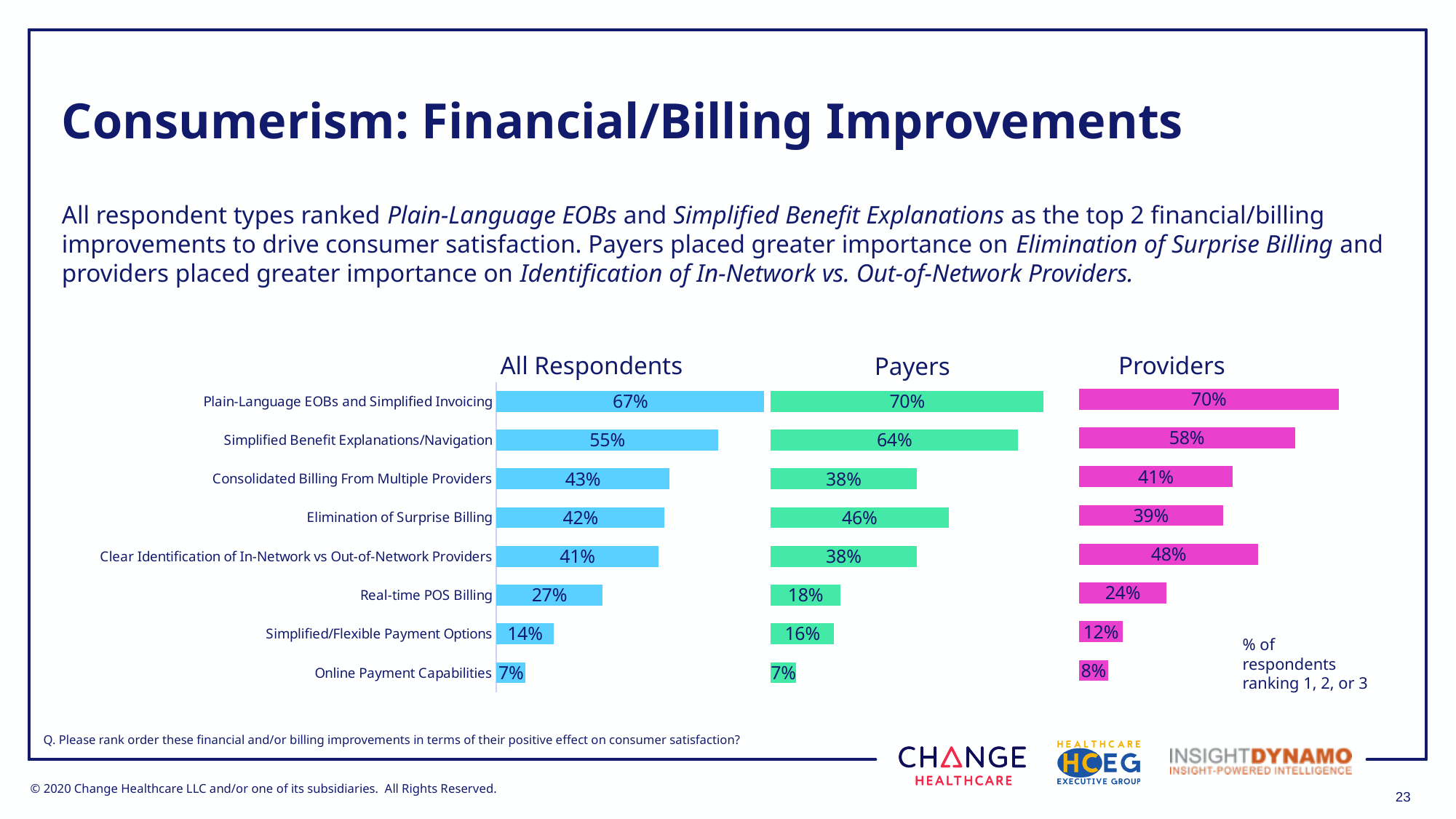
What type of chart is used for the Payers data? Bar chart In the Providers chart, what percentage is shown for Clear Identification of In-Network vs Out-of-Network Providers? 48% In the Payers chart, what percentage is shown for Elimination of Surprise Billing? 46% In the All Respondents chart, what is the difference between Plain-Language EOBs and Simplified Invoicing and Simplified Benefit Explanations/Navigation? 12% How many categories are shown in the All Respondents chart? 8 In the Providers chart, which category has the highest value? Plain-Language EOBs and Simplified Invoicing What colour are the bars in the Providers chart? Magenta In the Payers chart, which category has the lowest value? Online Payment Capabilities In the Payers chart, what is the difference between Simplified Benefit Explanations/Navigation and Consolidated Billing From Multiple Providers? 26% Which is larger: the Providers value for Real-time POS Billing or the Payers value for Real-time POS Billing? Providers In the All Respondents chart, what percentage is shown for Plain-Language EOBs and Simplified Invoicing? 67% Which is larger: the Payers value for Elimination of Surprise Billing or the Providers value for Elimination of Surprise Billing? Payers